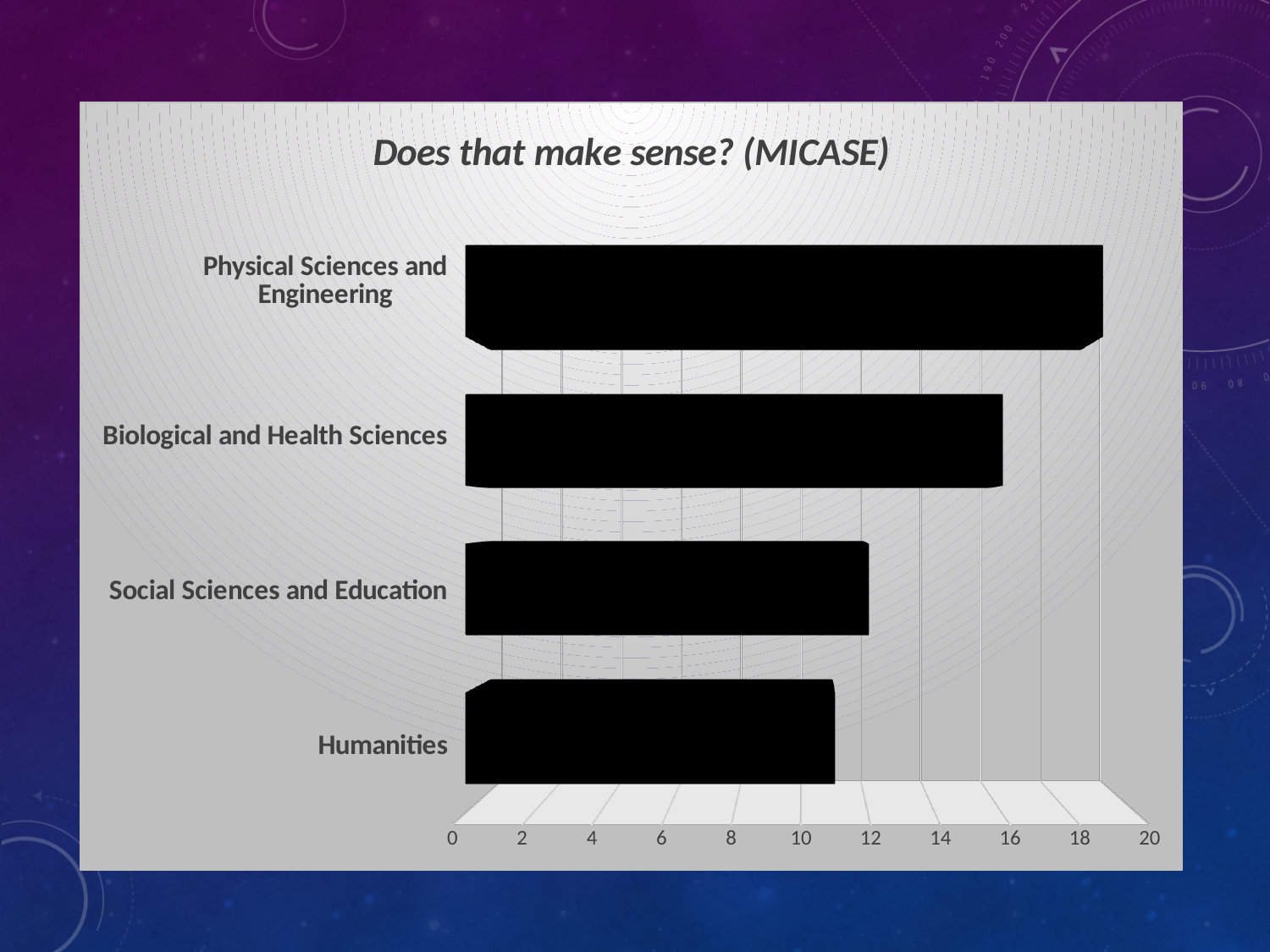
Is the value for Social Sciences and Education greater or less than 10? greater Is the value for Physical Sciences and Engineering greater or less than 16? greater Is the value for Humanities greater or less than 12? less Do the bar values increase or decrease going from the top category to the bottom category? decrease What kind of chart is shown on the slide? bar chart Which category has the highest value? Physical Sciences and Engineering Which category has the lowest value? Humanities Which has a larger value, Biological and Health Sciences or Social Sciences and Education? Biological and Health Sciences Which has a larger value, Humanities or Physical Sciences and Engineering? Physical Sciences and Engineering What is the title of the chart? Does that make sense? (MICASE) How many categories are shown in the chart? 4